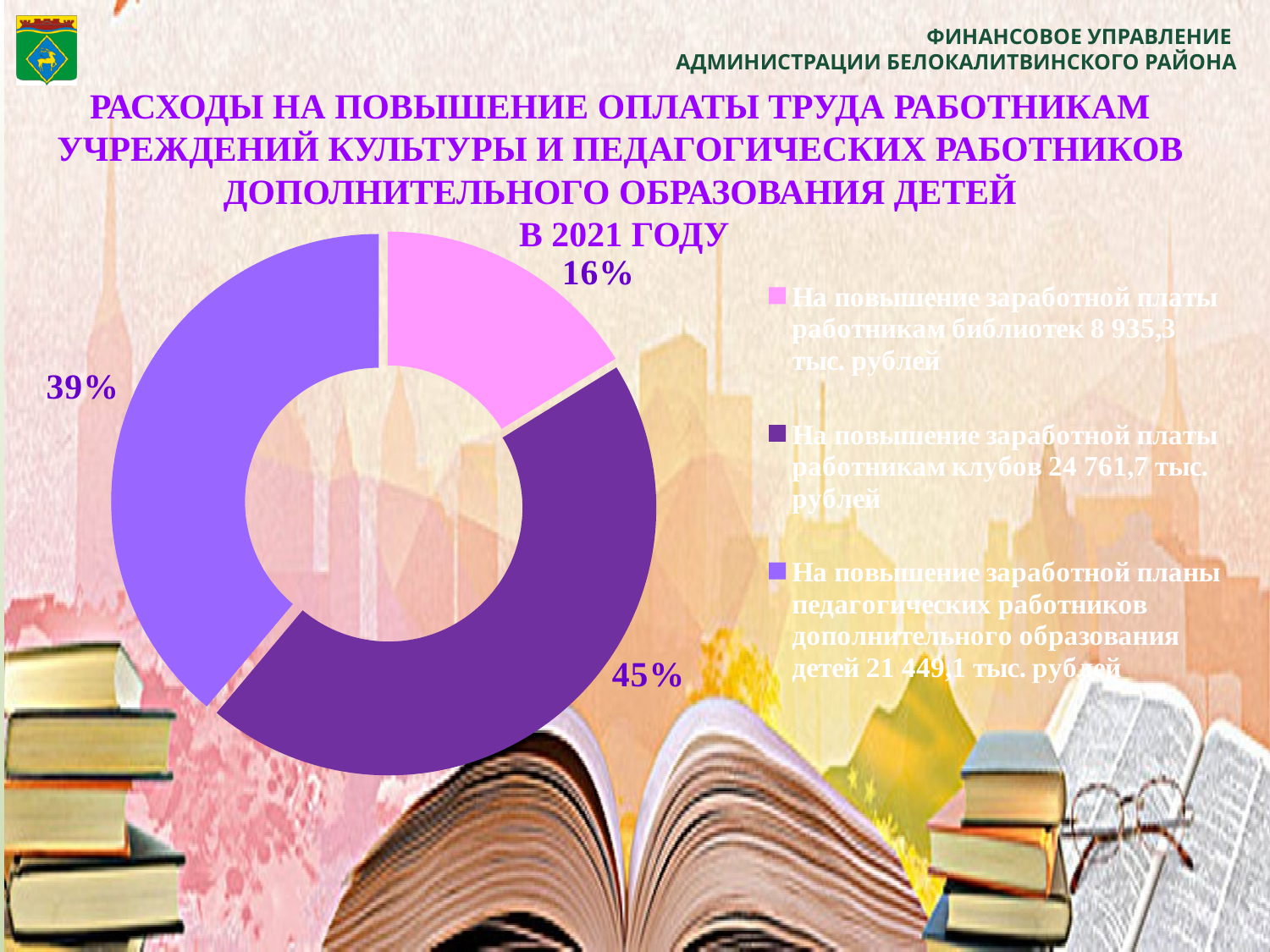
Какая категория имеет наименьшую долю на диаграмме? На повышение заработной платы работникам библиотек Какую долю составляют расходы на повышение заработной платы работникам клубов? 45% Что больше: доля расходов на работников библиотек или доля расходов на педагогических работников дополнительного образования детей? на педагогических работников дополнительного образования детей Какая категория имеет наибольшую долю на диаграмме? На повышение заработной платы работникам клубов Какая сумма расходов на повышение заработной платы работникам библиотек указана в легенде? 8 935,3 тыс. рублей На сколько процентных пунктов доля расходов на работников клубов больше доли расходов на педагогических работников дополнительного образования? 6 Сколько категорий (секторов) показано на диаграмме? 3 Каким цветом на диаграмме обозначены расходы на повышение заработной платы работникам библиотек? розовым Какую долю составляют расходы на повышение заработной платы работникам библиотек? 16% Какую долю составляют расходы на повышение заработной платы педагогических работников дополнительного образования детей? 39% Какая сумма расходов на повышение заработной платы работникам клубов указана в легенде? 24 761,7 тыс. рублей Какой тип диаграммы показан на слайде? кольцевая (круговая) диаграмма